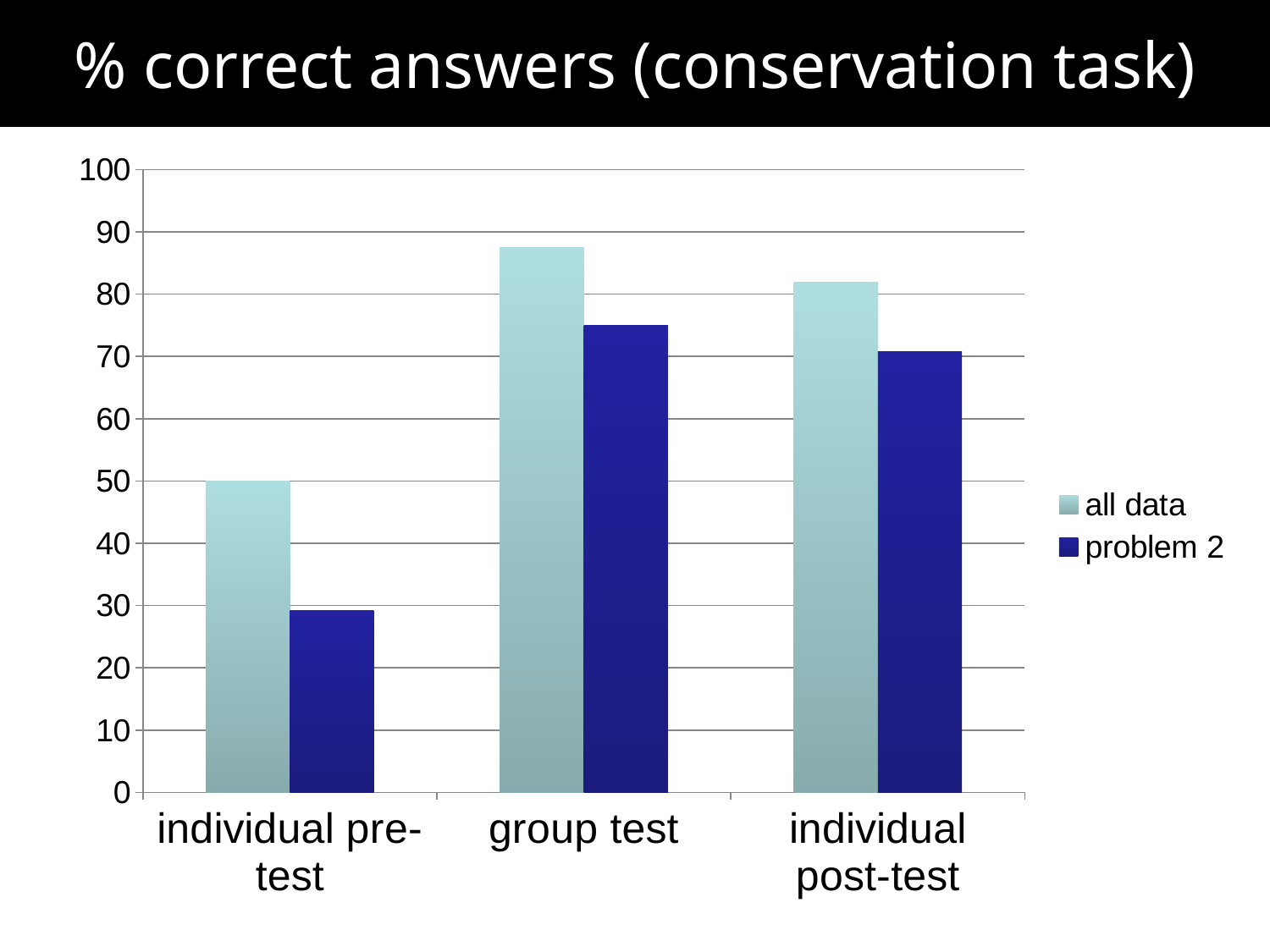
Which series is shown in dark blue in the legend? problem 2 What is the title of the chart? % correct answers (conservation task) What kind of chart is shown on the slide? bar chart Which is larger in the individual post-test: the 'all data' value or the 'problem 2' value? all data How many categories are shown on the x axis? 3 Which category has the highest value for the 'all data' series? group test Which is larger for the 'problem 2' series: the group test value or the individual post-test value? group test Is the value for 'all data' in the group test greater or less than 80? greater How many series does the legend list? 2 Which category has the lowest value for the 'problem 2' series? individual pre-test Is the value for 'problem 2' in the individual post-test greater or less than 60? greater Is the value for 'problem 2' in the individual pre-test greater or less than 40? less